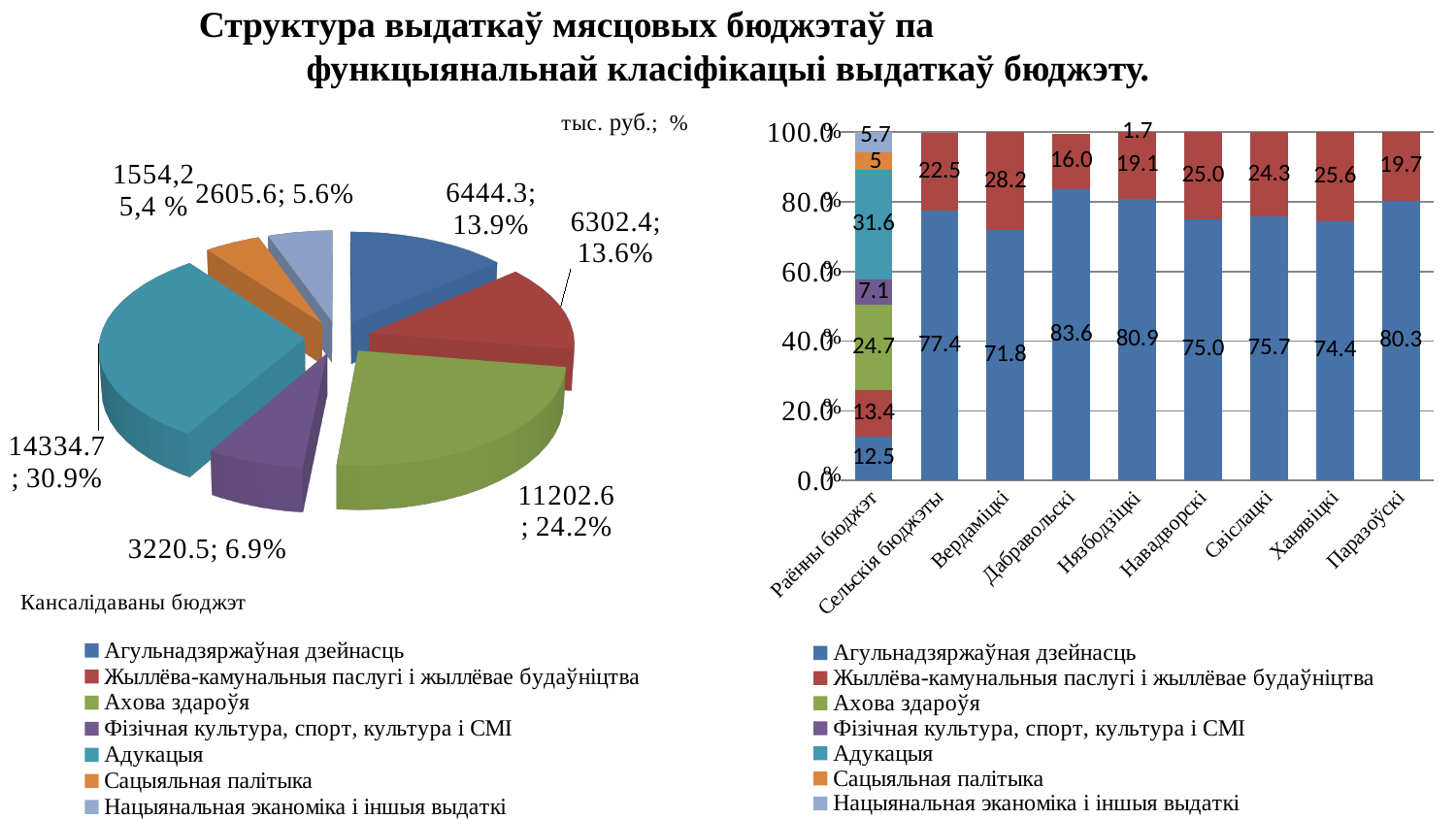
What type of chart is shown on the right side of the slide? Stacked bar chart On the stacked bar chart (right), which budget has the highest value for Агульнадзяржаўная дзейнасць? Дабравольскі On the stacked bar chart (right), what is the value of Жыллёва-камунальныя паслугі і жыллёвае будаўніцтва for Вердаміцкі? 28.2 On the stacked bar chart (right), how many series does the legend list? 7 On the pie chart (left), how many slices are there? 7 On the pie chart (left), which category has the largest slice? Адукацыя On the pie chart (left), what is the percentage for Фізічная культура, спорт, культура і СМІ? 6.9% On the stacked bar chart (right), what is the difference between the Агульнадзяржаўная дзейнасць values for Паразоўскі and Ханявіцкі? 5.9 On the pie chart (left), what value is shown for Ахова здароўя? 11202.6 On the pie chart (left), which category has the smallest slice? Сацыяльная палітыка On the pie chart (left), what is the share of Адукацыя? 30.9% On the stacked bar chart (right), what is the value of Агульнадзяржаўная дзейнасць for Дабравольскі? 83.6